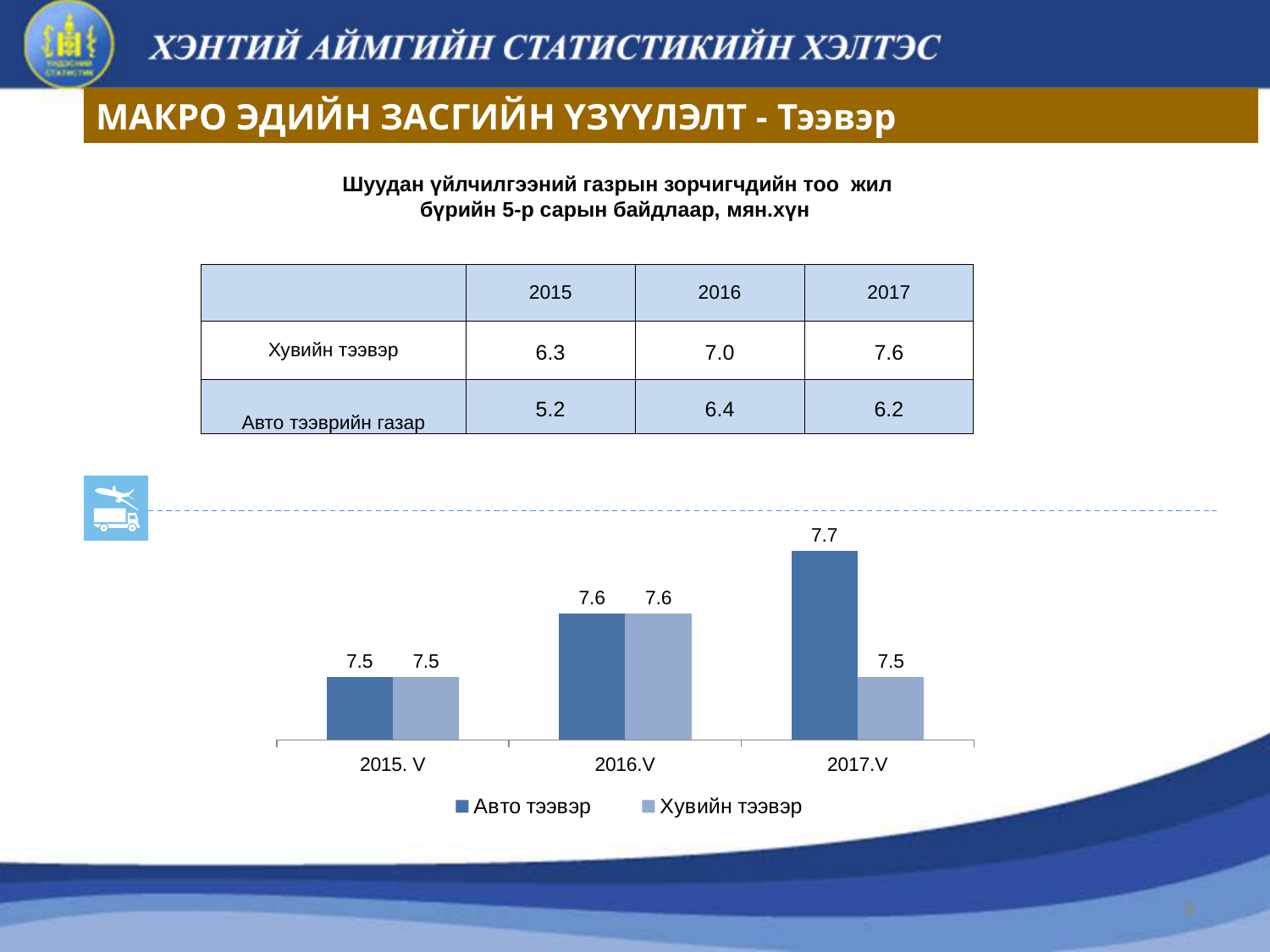
What is the difference between Авто тээвэр and Хувийн тээвэр in 2017.V? 0.2 Does the Авто тээвэр value rise or fall from 2015. V to 2017.V? rise What is the value for Авто тээвэр in 2017.V? 7.7 What kind of chart is shown on the slide? bar chart How many series does the chart legend list? 2 In which period is the Авто тээвэр value highest? 2017.V What is the value for Хувийн тээвэр in 2017.V? 7.5 How many periods are shown on the x axis of the chart? 3 What is the value for Авто тээвэр in 2015. V? 7.5 What is the value for Хувийн тээвэр in 2016.V? 7.6 In 2017.V, which is larger: Авто тээвэр or Хувийн тээвэр? Авто тээвэр In which period is the Авто тээвэр value lowest? 2015. V